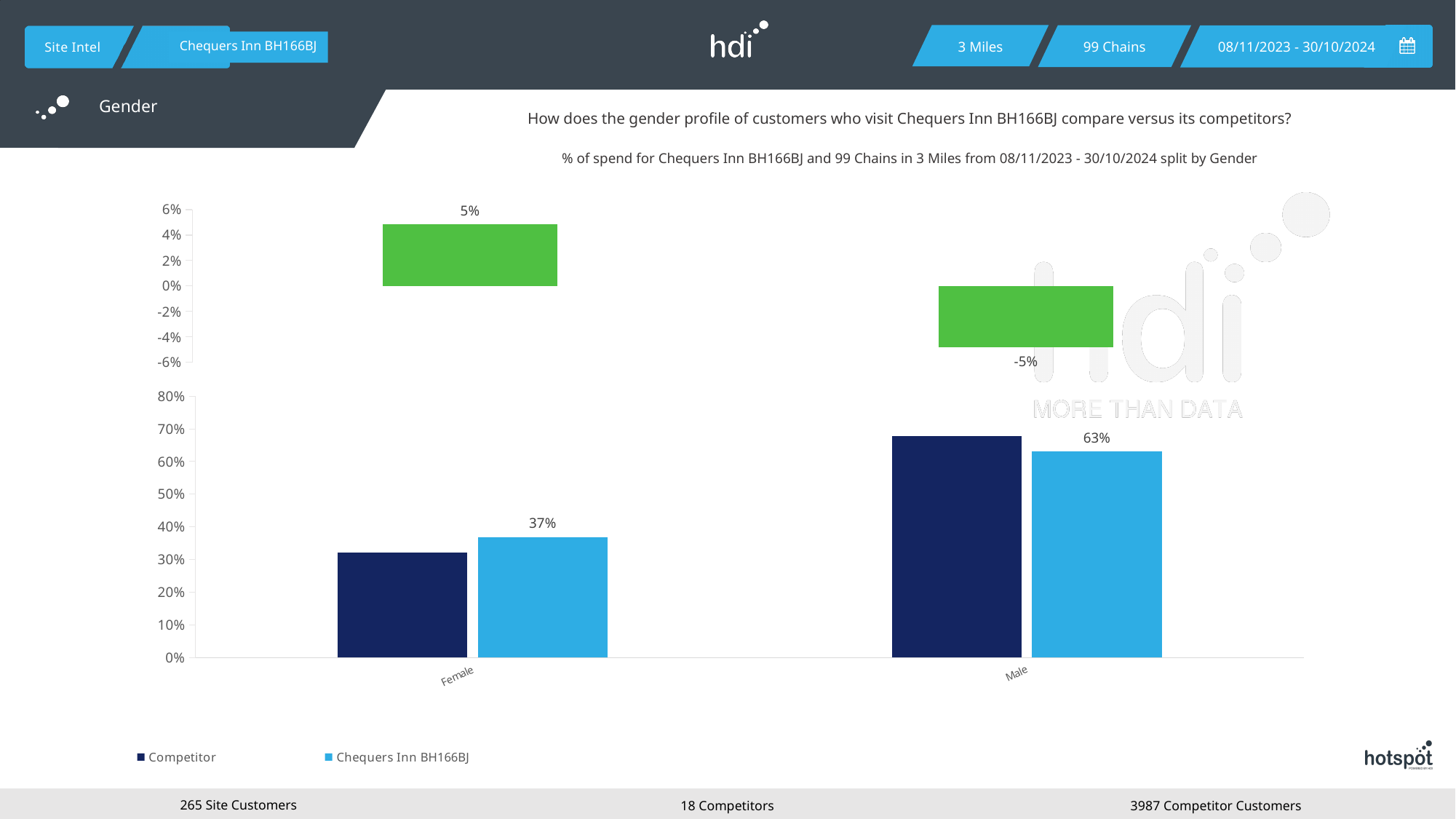
In the bottom bar chart, for Male, which is larger: the Competitor value or the Chequers Inn BH166BJ value? Competitor In the bottom bar chart, is the Competitor value for Female greater or less than 40%? less In the bottom bar chart, what is the value for Chequers Inn BH166BJ for Male? 63% What kind of chart is the bottom chart? bar chart In the top chart, what is the value shown for Female? 5% In the bottom bar chart, is the Competitor value for Male greater or less than 60%? greater In the bottom bar chart, what is the difference between the Chequers Inn BH166BJ values for Male and Female? 26% How many categories are shown on the x axis of the bottom bar chart? 2 In the top chart, what is the value shown for Male? -5% In the bottom bar chart, which gender has the higher value for Chequers Inn BH166BJ? Male How many series does the legend of the bottom bar chart list? 2 In the bottom bar chart, what is the value for Chequers Inn BH166BJ for Female? 37%